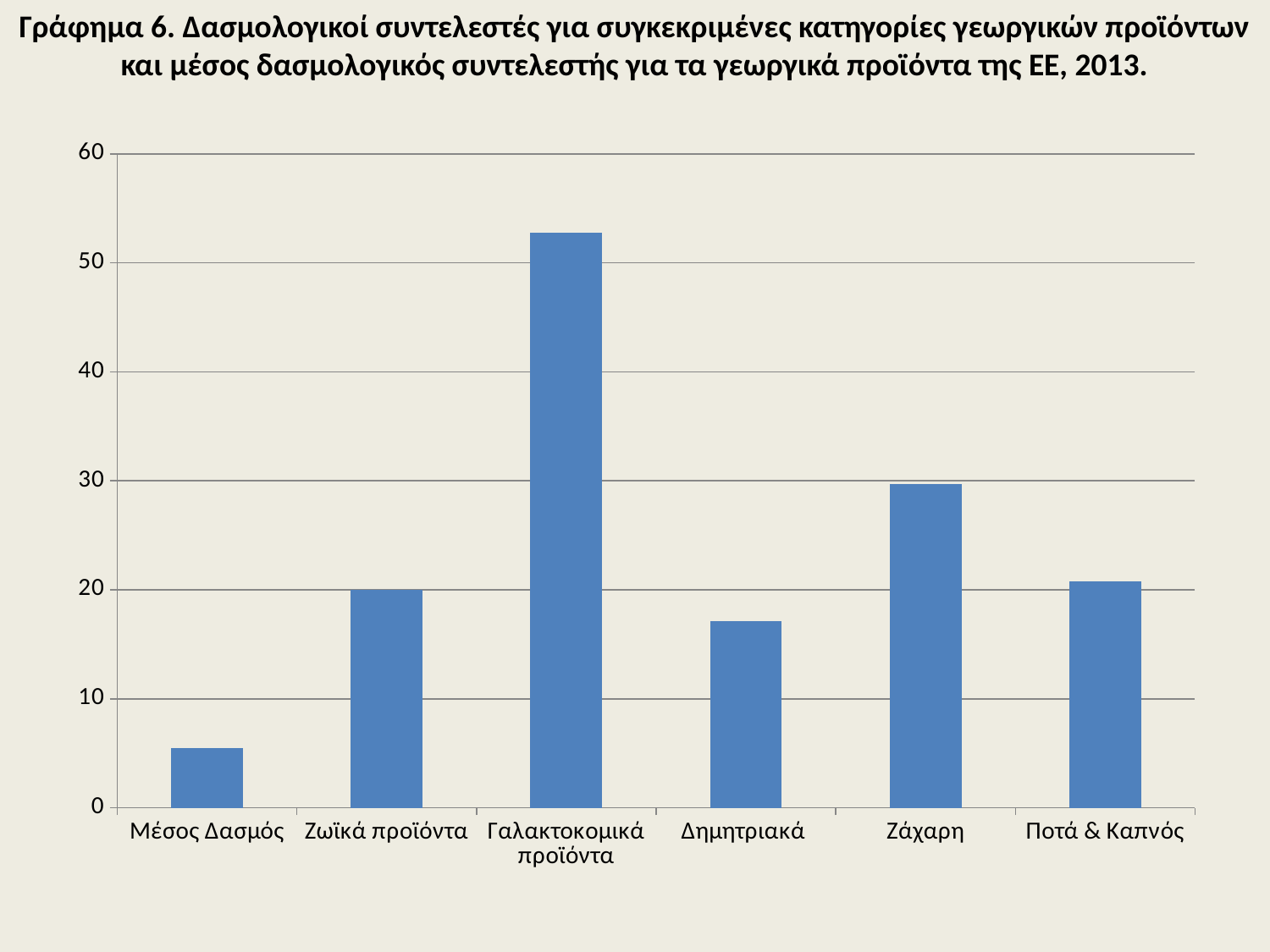
How many categories are shown on the x axis of the chart? 6 Which is larger, the value for Ζάχαρη or the value for Δημητριακά? Ζάχαρη Which is larger, the value for Μέσος Δασμός or the value for Ζωικά προϊόντα? Ζωικά προϊόντα Is the value for Μέσος Δασμός greater or less than 10? less What is the highest value shown on the y axis of the chart? 60 Which category has the lowest value in the chart? Μέσος Δασμός What kind of chart is shown on the slide? bar chart Is the value for Γαλακτοκομικά προϊόντα greater or less than 50? greater Is the value for Δημητριακά greater or less than 20? less Which category has the highest value in the chart? Γαλακτοκομικά προϊόντα